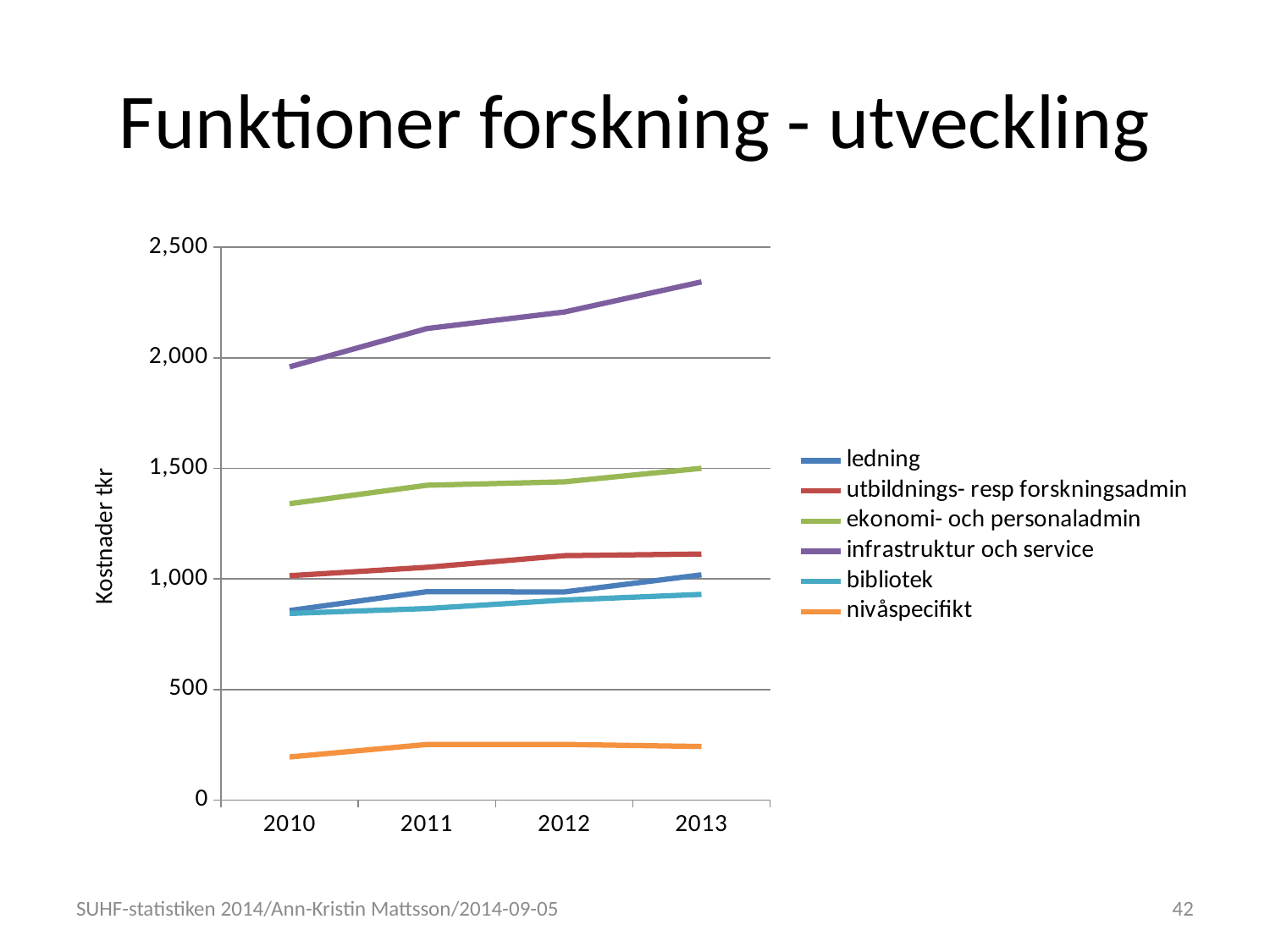
Is the value for nivåspecifikt in 2010 greater or less than 500? less Is the value for infrastruktur och service in 2013 greater or less than 2,000? greater What kind of chart is shown on the slide? line chart Do the values for infrastruktur och service rise or fall from 2010 to 2013? rise What is the label on the vertical axis? Kostnader tkr In 2013, which is larger: utbildnings- resp forskningsadmin or bibliotek? utbildnings- resp forskningsadmin Is the value for ekonomi- och personaladmin in 2013 greater or less than 1,000? greater Which series has the lowest values across all years? nivåspecifikt Do the values for ekonomi- och personaladmin rise or fall from 2010 to 2013? rise How many years are shown on the x axis? 4 How many series does the legend list? 6 Which series has the highest values across all years? infrastruktur och service